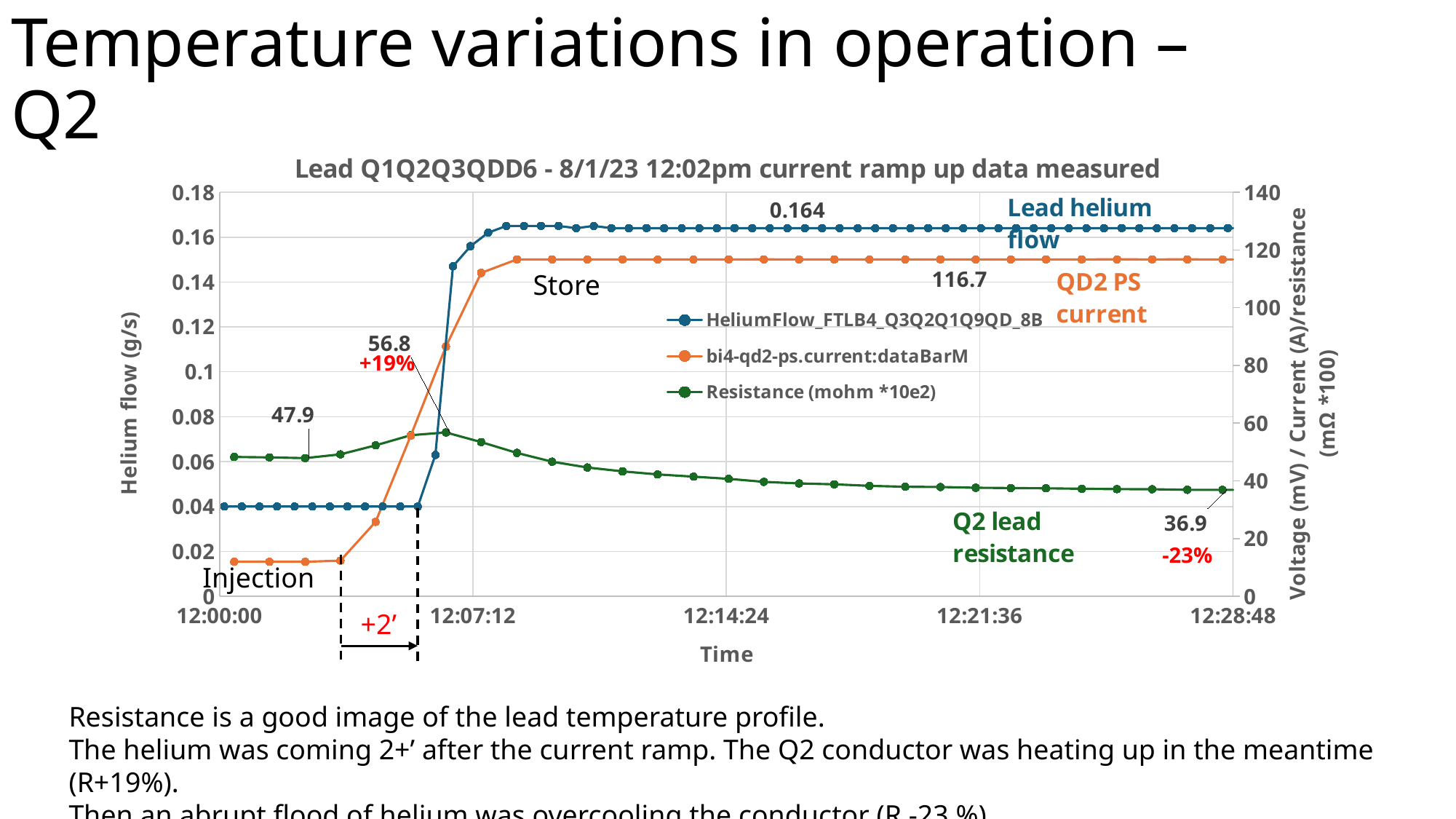
How many series does the chart legend list? 3 Is the lead helium flow value at 12:00:00 greater or less than 0.06 g/s? less What is the labelled peak value of the Q2 lead resistance series? 56.8 After its peak near 12:07:12, does the Q2 lead resistance series rise or fall along the time axis? fall What is the labelled plateau value of the QD2 PS current series? 116.7 What kind of chart is shown on the slide? line chart What is the labelled value of the Q2 lead resistance at the end of the chart (12:28:48)? 36.9 What is the labelled value of the Q2 lead resistance at the start of the chart? 47.9 What is the title of the chart? Lead Q1Q2Q3QDD6 - 8/1/23 12:02pm current ramp up data measured What is the difference between the peak resistance value (56.8) and the starting resistance value (47.9)? 8.9 What is the difference between the peak resistance value (56.8) and the final resistance value (36.9)? 19.9 What is the labelled plateau value of the lead helium flow series? 0.164